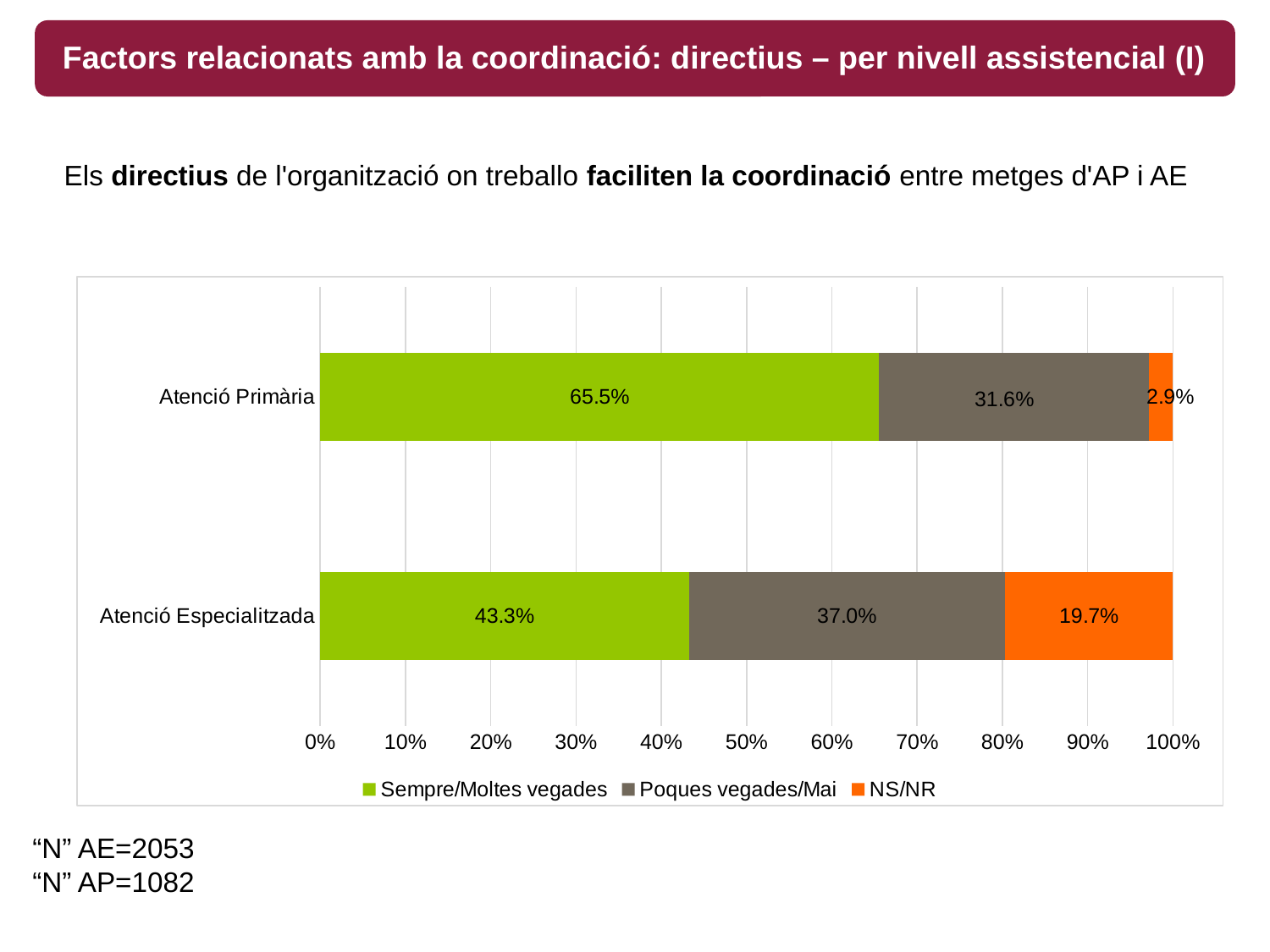
Which category has the higher value for Sempre/Moltes vegades? Atenció Primària What is the value for Poques vegades/Mai for Atenció Especialitzada? 37.0% Which is larger: Poques vegades/Mai for Atenció Primària or for Atenció Especialitzada? Atenció Especialitzada How many categories are shown on the y axis? 2 Which colour represents the NS/NR series in the legend? Orange What is the value for NS/NR for Atenció Primària? 2.9% How many series does the legend list? 3 What is the difference between the Sempre/Moltes vegades values for Atenció Primària and Atenció Especialitzada? 22.2% What is the value for Sempre/Moltes vegades for Atenció Primària? 65.5% What is the value for NS/NR for Atenció Especialitzada? 19.7% Which category has the lower value for NS/NR? Atenció Primària What kind of chart is shown on the slide? Stacked bar chart